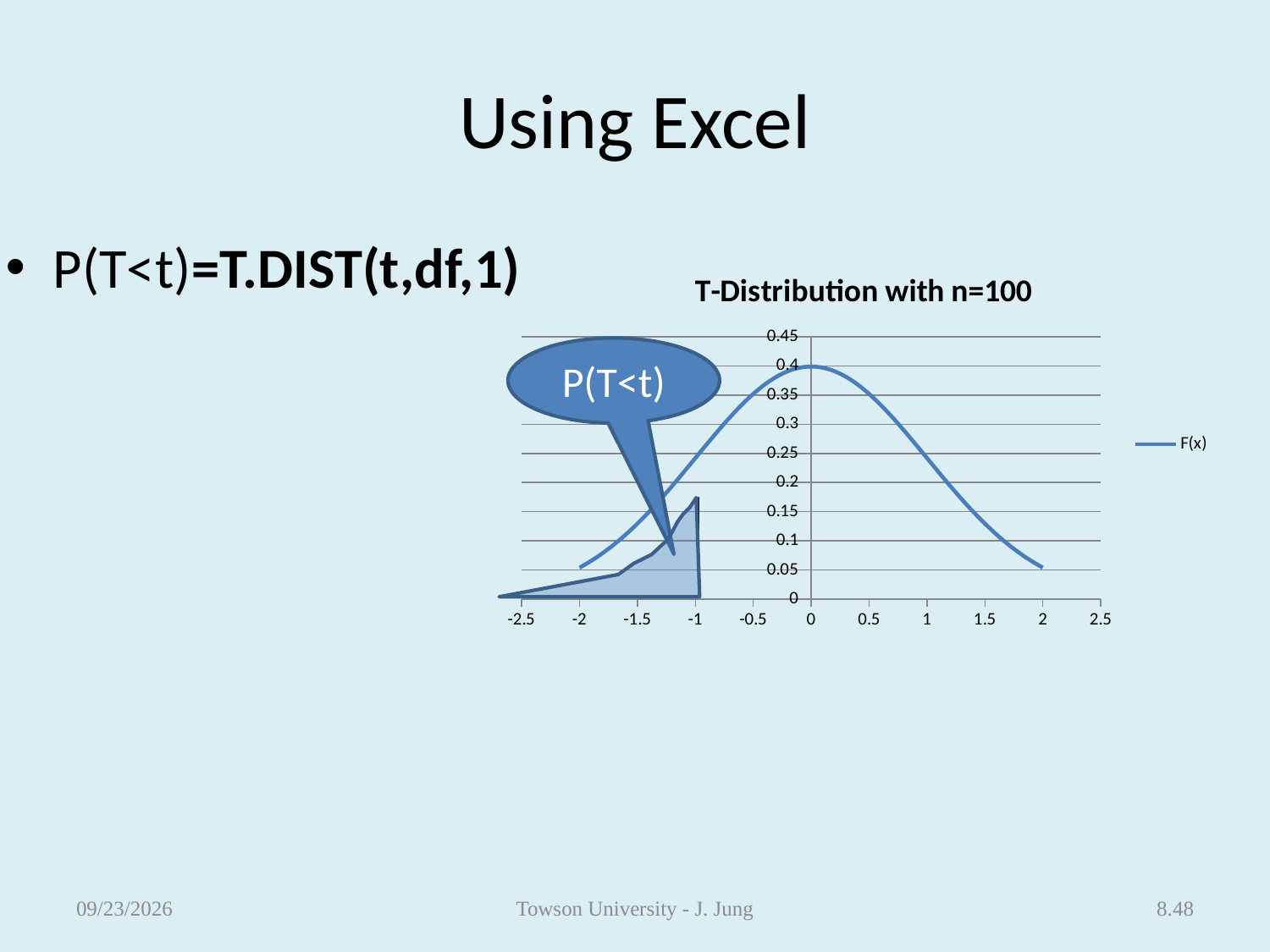
Is the value of F(x) at x = 1 greater or less than 0.2? greater Does the F(x) curve rise or fall as x goes from -2 to 0? rise Does the F(x) curve rise or fall as x goes from 0 to 2? fall Is the value of F(x) at x = 2 greater or less than 0.1? less At which x value does the F(x) curve reach its highest point? 0 Is the value of F(x) at x = -2 greater or less than 0.1? less Which is larger, the value of F(x) at x = 0 or at x = 2? x = 0 What is the title of the chart? T-Distribution with n=100 What is the name of the series shown in the chart legend? F(x) What kind of chart is shown on the slide? line chart How many series does the chart legend list? 1